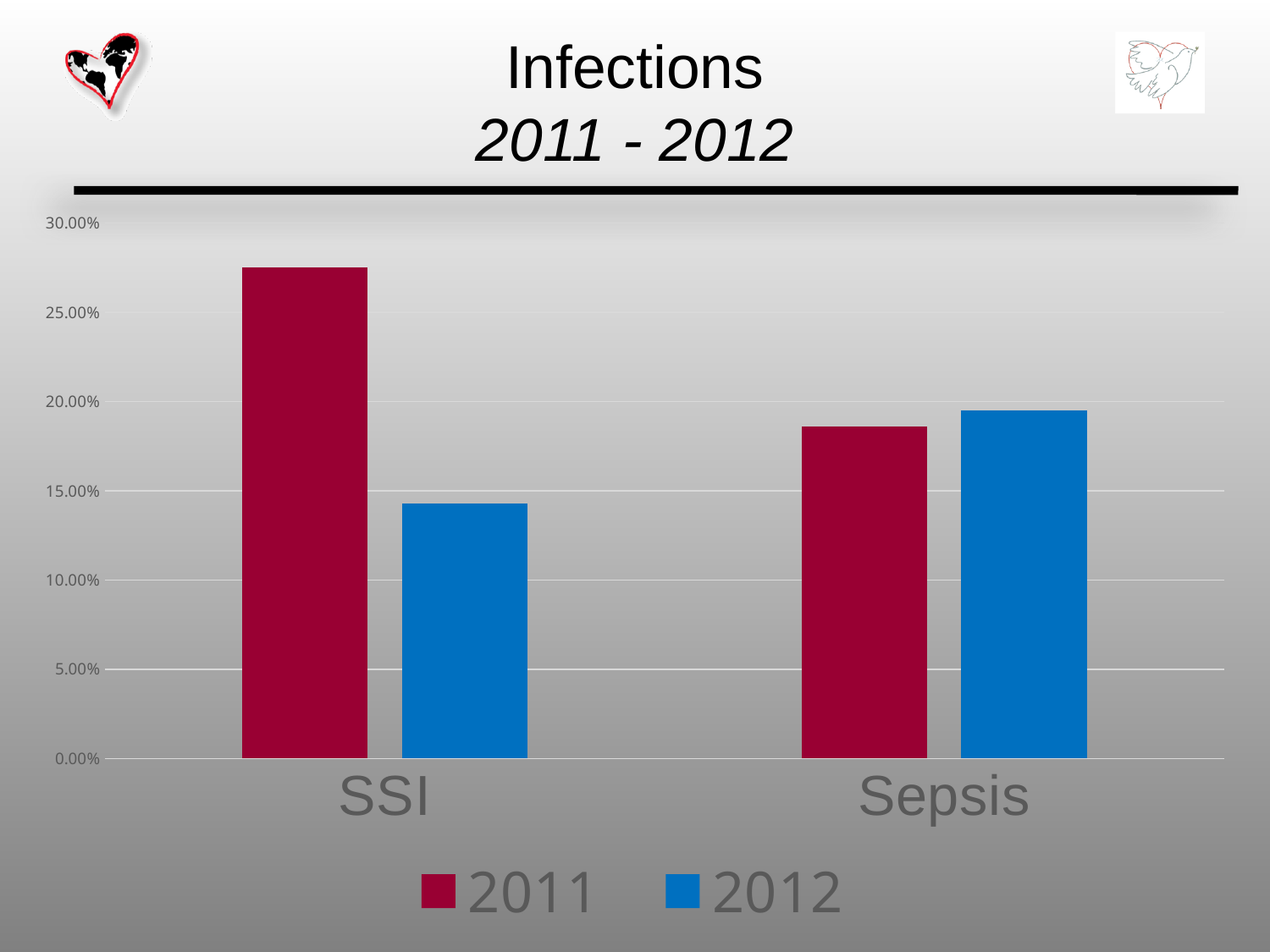
How many categories are shown on the x axis? 2 Is the 2012 value for SSI greater or less than 15.00%? less Which colour represents the 2012 series in the legend? blue Which category has the highest 2011 value? SSI How many series does the legend list? 2 Is the 2011 value for SSI greater or less than 25.00%? greater Does the 2011 series rise or fall from SSI to Sepsis? fall Is the 2012 value for Sepsis greater or less than 20.00%? less What kind of chart is shown on the slide? bar chart For 2012, which category has the larger value, SSI or Sepsis? Sepsis Which category has the lowest 2012 value? SSI For SSI, which year has the larger value, 2011 or 2012? 2011